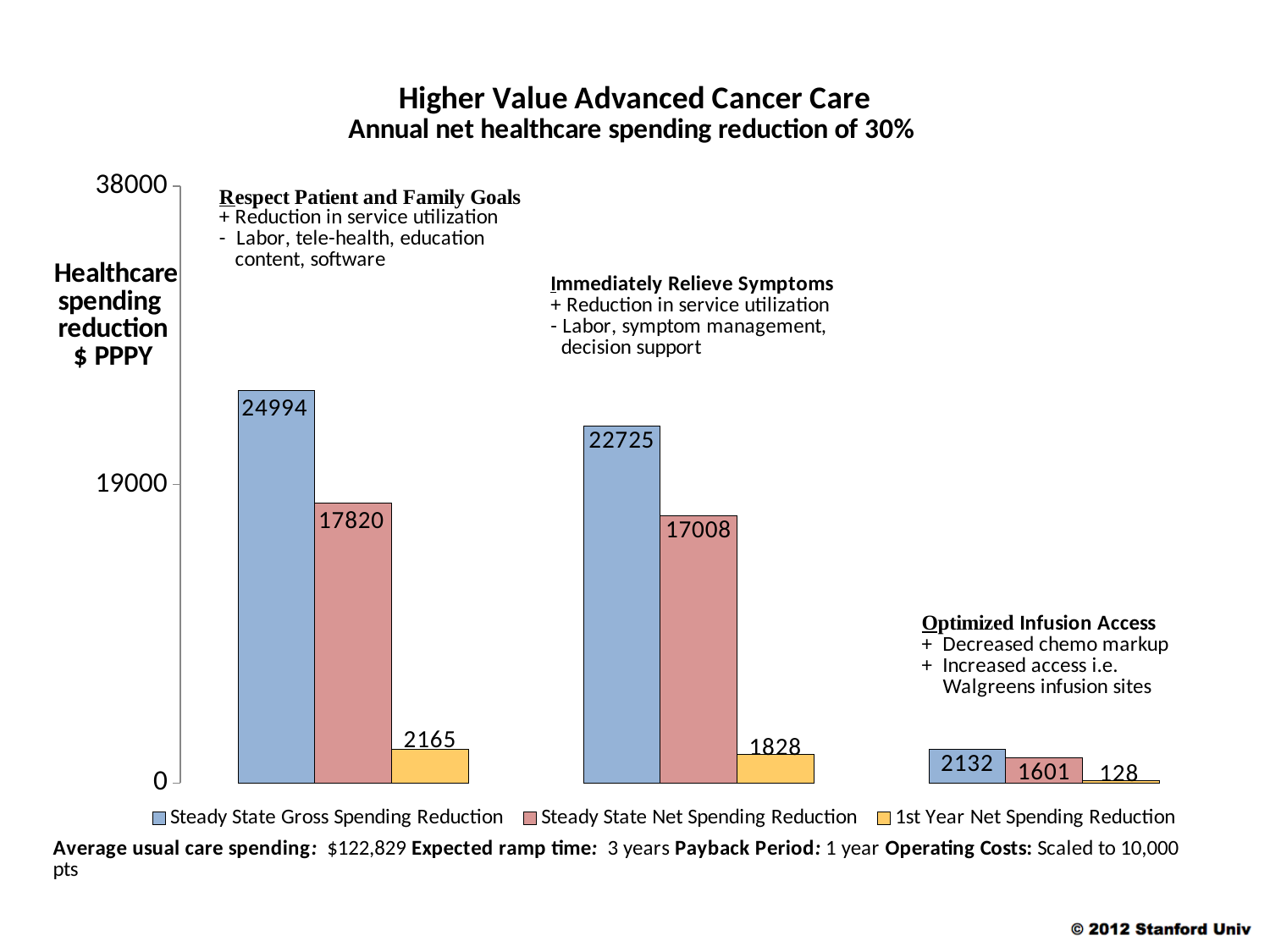
How many series does the legend list? 3 What kind of chart is shown on the slide? bar chart Which category has the lowest 1st Year Net Spending Reduction? Optimized Infusion Access Which category has the highest Steady State Gross Spending Reduction? Respect Patient and Family Goals What is the difference between the Steady State Gross and Steady State Net Spending Reduction for Respect Patient and Family Goals? 7174 Which is larger: the 1st Year Net Spending Reduction for Respect Patient and Family Goals or for Immediately Relieve Symptoms? Respect Patient and Family Goals What is the Steady State Gross Spending Reduction for Respect Patient and Family Goals? 24994 How many categories (groups of bars) are shown in the chart? 3 Is the Steady State Net Spending Reduction for Immediately Relieve Symptoms greater or less than 19000? less What is the Steady State Net Spending Reduction for Immediately Relieve Symptoms? 17008 What is the y-axis label of the chart? Healthcare spending reduction $ PPPY What is the 1st Year Net Spending Reduction for Optimized Infusion Access? 128